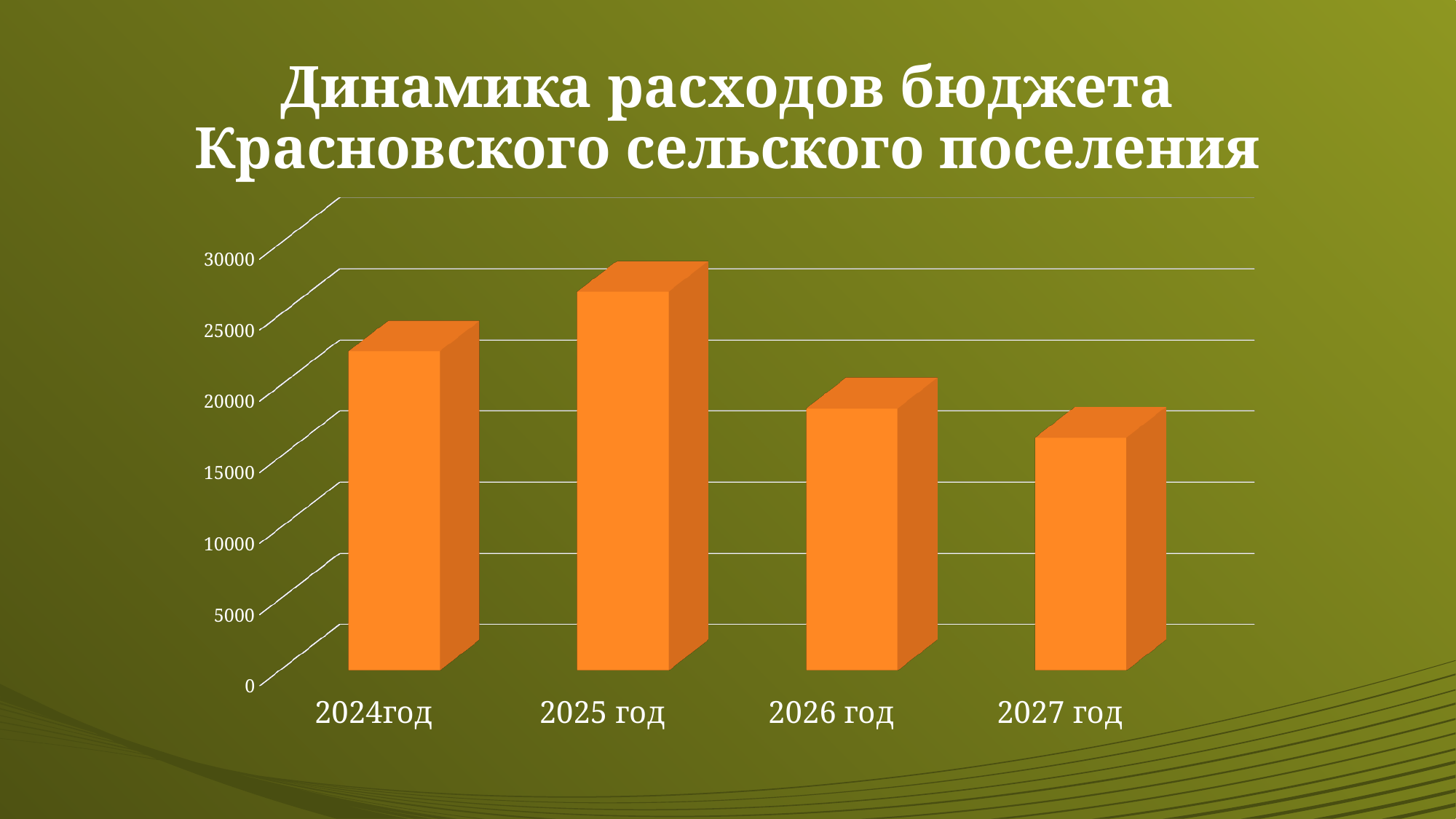
What is the title of the chart on the slide? Динамика расходов бюджета Красновского сельского поселения Which is larger, the value for 2024год or the value for 2026 год? 2024год Is the value for 2024год greater or less than 20000? greater Which year has the lowest bar in the chart? 2027 год Is the value for 2026 год greater or less than 15000? greater How many years (categories) are shown on the x axis of the chart? 4 Which year has the highest bar in the chart? 2025 год Do the values rise or fall from 2025 год to 2027 год? fall Is the value for 2027 год greater or less than 20000? less What kind of chart is shown on the slide? bar chart